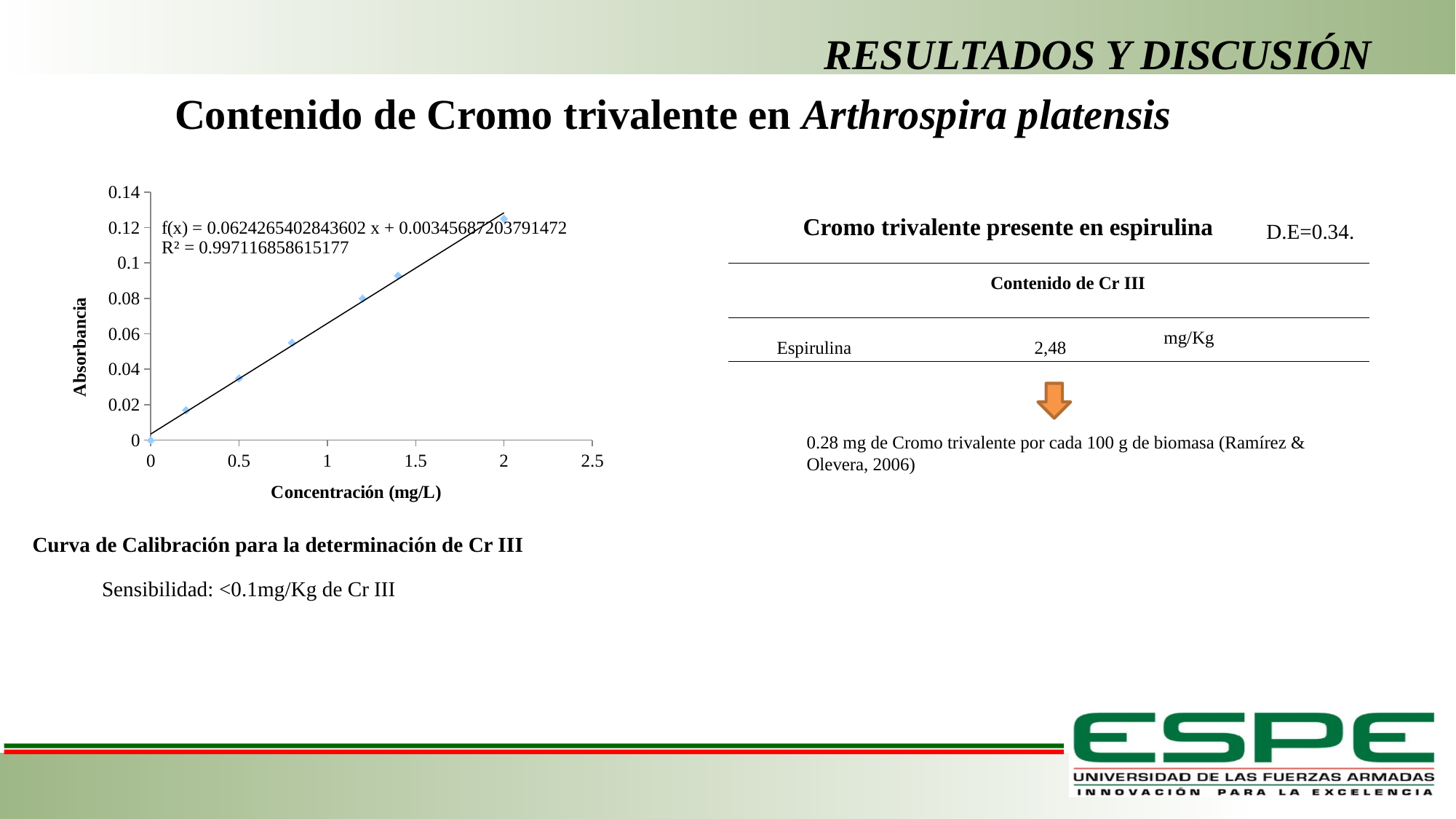
Is the absorbance at a concentration of 0.8 mg/L greater or less than 0.04? greater Which has the larger absorbance: the point at concentration 1.2 or the point at concentration 0.5? 1.2 At which concentration is the absorbance highest? 2 Do the absorbance values rise or fall as concentration increases along the x axis? Rise What is the R² value shown on the chart? 0.997116858615177 Is the absorbance at a concentration of 2 mg/L greater or less than 0.1? greater What kind of chart is shown on the slide? Scatter chart What is the title of the x axis of the chart? Concentración (mg/L) Is the absorbance at a concentration of 1.4 mg/L greater or less than 0.08? greater How many data points are plotted in the calibration curve chart? 7 At which concentration is the absorbance lowest? 0